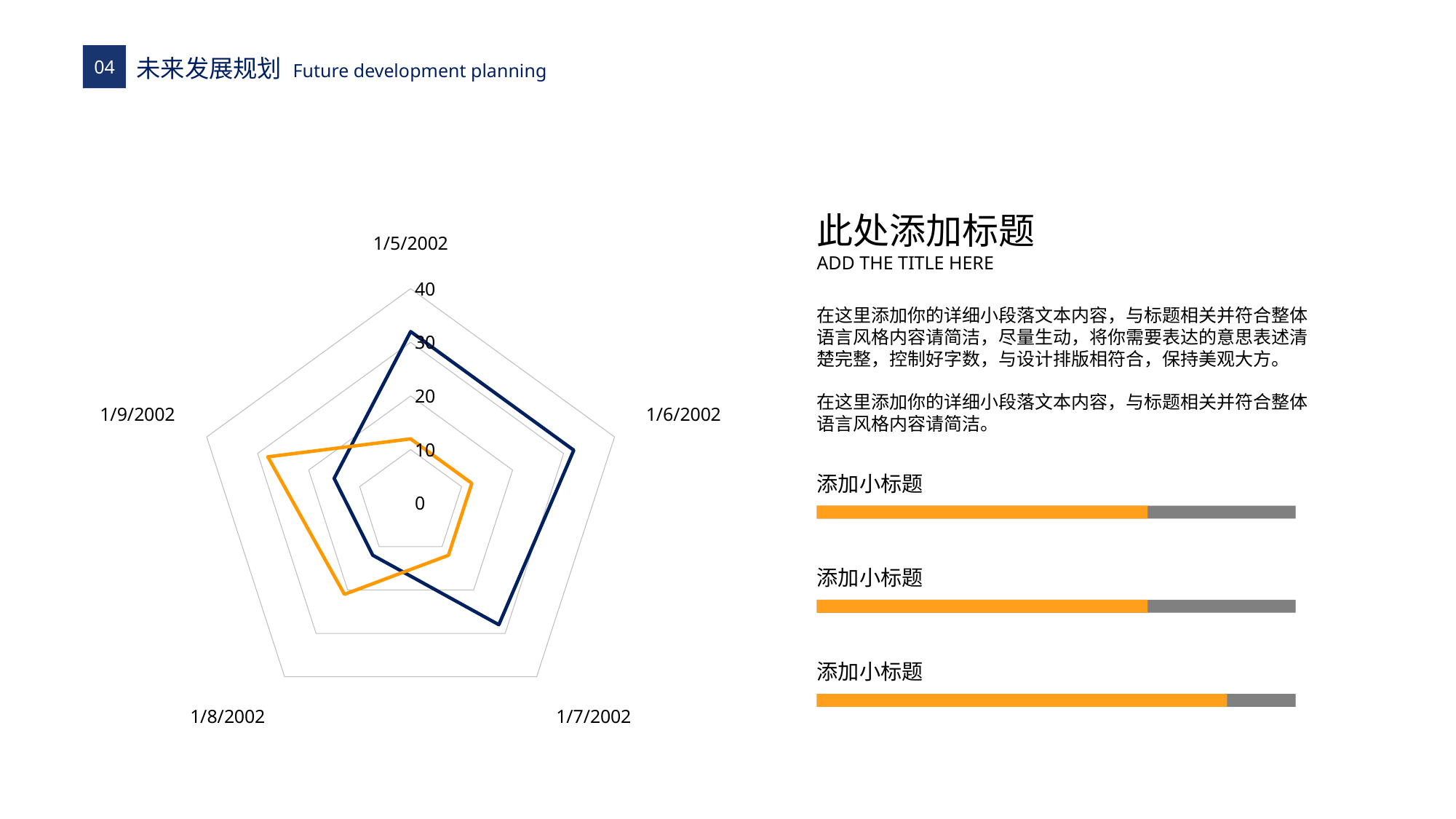
What is the highest value shown on the radar chart's axis scale? 40 What colours are the two series lines on the radar chart? dark blue and orange Is the orange series value for 1/9/2002 greater or less than 20? greater How many categories (axes) does the radar chart have? 5 How many data series are plotted on the radar chart? 2 Is the dark blue series value for 1/7/2002 greater or less than 20? greater Is the orange series value for 1/6/2002 greater or less than 20? less What kind of chart is shown on the slide? radar chart At 1/5/2002, which series has the larger value, the dark blue or the orange? dark blue For which category does the orange series reach its highest value? 1/9/2002